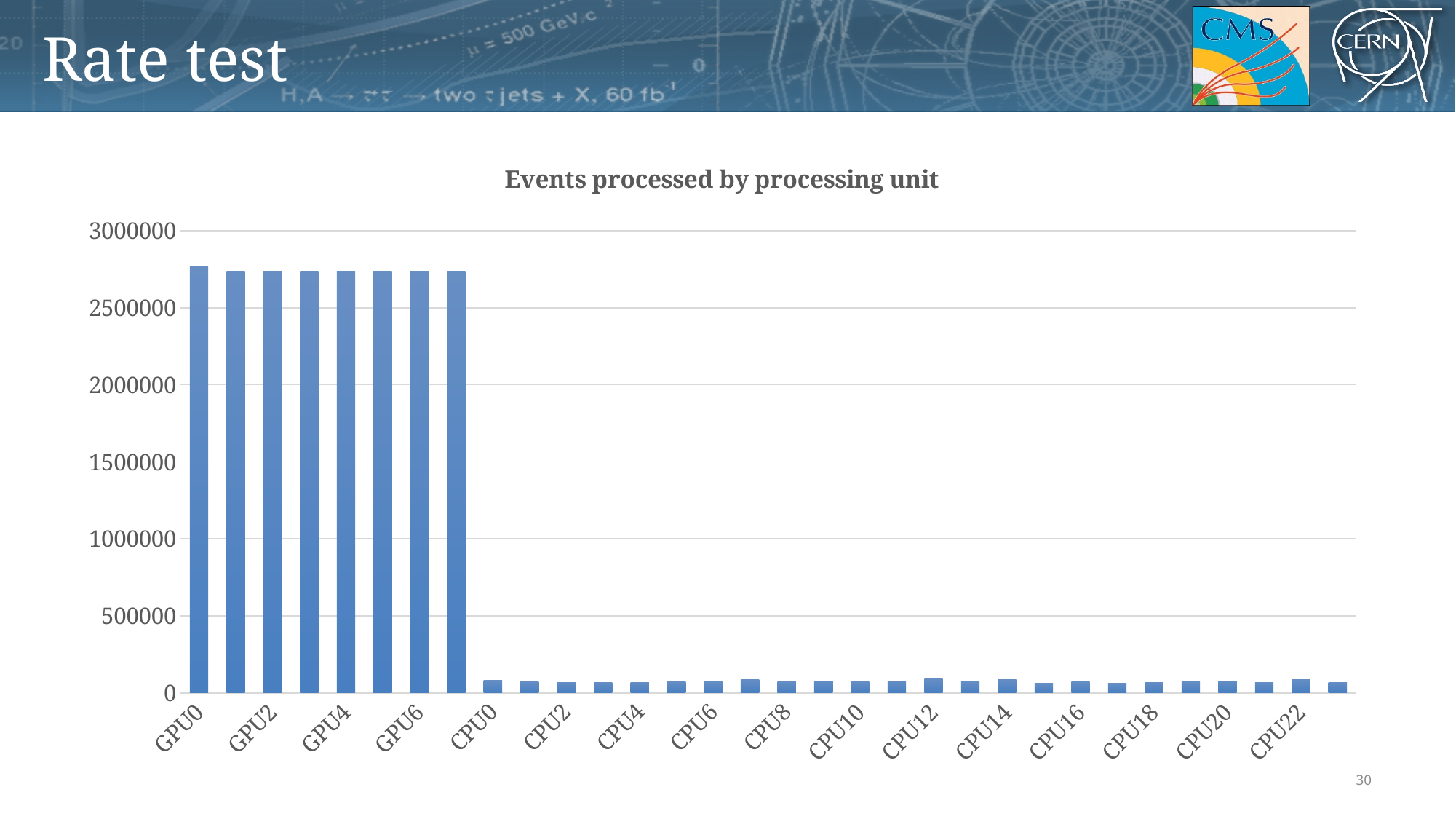
What kind of chart is shown on the slide? bar chart What is the title of the chart? Events processed by processing unit What colour are the bars in the chart? blue Which has the larger value, GPU2 or CPU2? GPU2 What is the highest value shown on the vertical axis? 3000000 Is the value for CPU0 greater or less than 500000? less Which has the larger value, CPU10 or GPU6? GPU6 Is the value for GPU0 greater or less than 2500000? greater Is the value for GPU6 greater or less than 3000000? less How many bars are plotted in the chart? 32